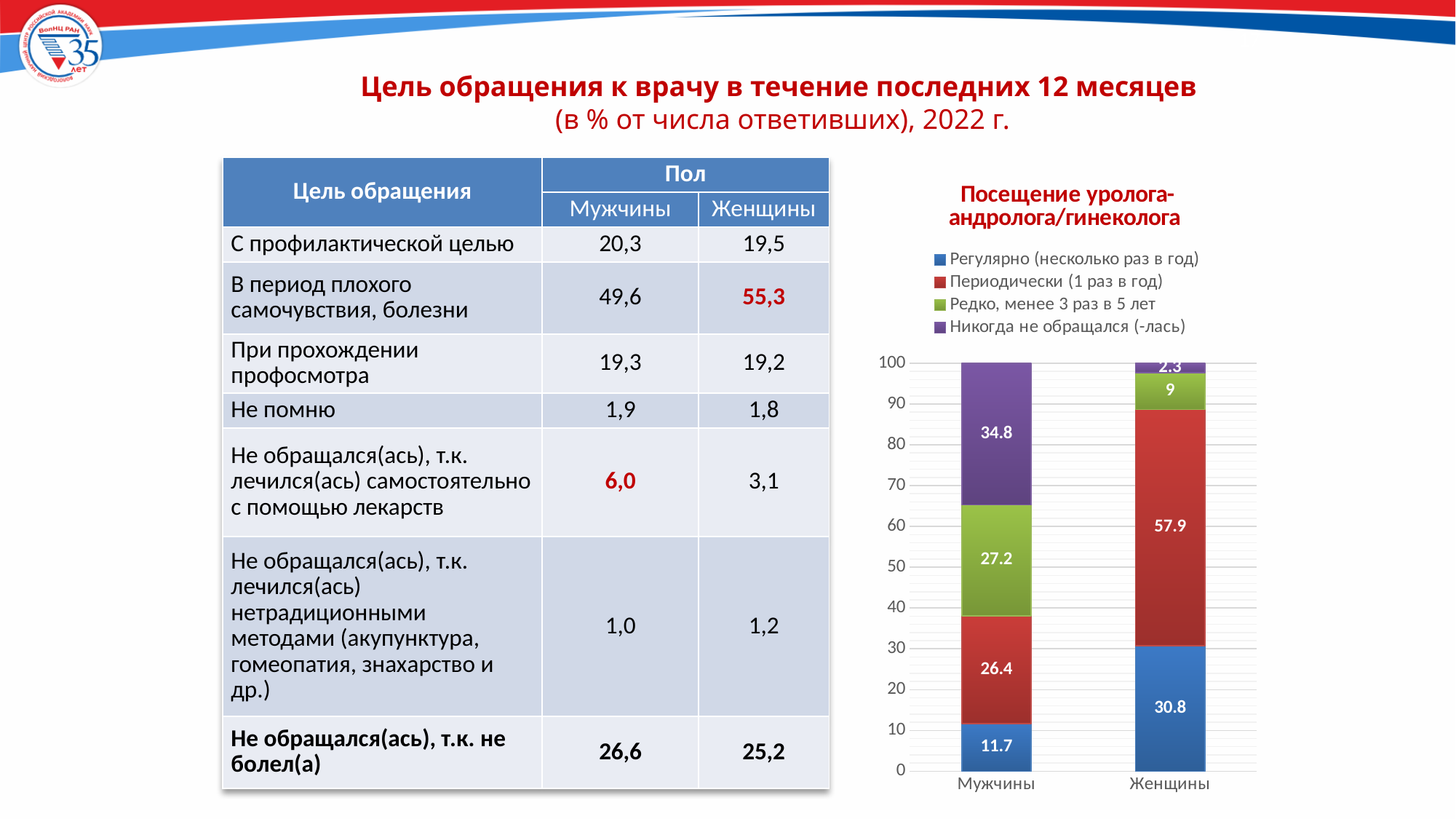
In the chart 'Посещение уролога-андролога/гинеколога', what is the value for 'Никогда не обращался (-лась)' for Мужчины? 34.8 In the chart 'Посещение уролога-андролога/гинеколога', what is the value for 'Регулярно (несколько раз в год)' for Мужчины? 11.7 In the chart 'Посещение уролога-андролога/гинеколога', what is the difference between the 'Регулярно (несколько раз в год)' values for Женщины and Мужчины? 19.1 In the chart 'Посещение уролога-андролога/гинеколога', which series has the smallest value for Мужчины? Регулярно (несколько раз в год) In the chart 'Посещение уролога-андролога/гинеколога', what is the value for 'Редко, менее 3 раз в 5 лет' for Женщины? 9 What kind of chart is shown on the right side of the slide? Stacked bar chart How many series does the legend of the chart 'Посещение уролога-андролога/гинеколога' list? 4 In the chart 'Посещение уролога-андролога/гинеколога', which series has the largest value for Женщины? Периодически (1 раз в год) In the chart 'Посещение уролога-андролога/гинеколога', what is the value for 'Периодически (1 раз в год)' for Женщины? 57.9 In the chart 'Посещение уролога-андролога/гинеколога', what is the total of the stacked bar for Женщины? 100 In the chart 'Посещение уролога-андролога/гинеколога', which is larger: 'Никогда не обращался (-лась)' for Мужчины or for Женщины? Мужчины How many categories are shown on the x axis of the chart 'Посещение уролога-андролога/гинеколога'? 2